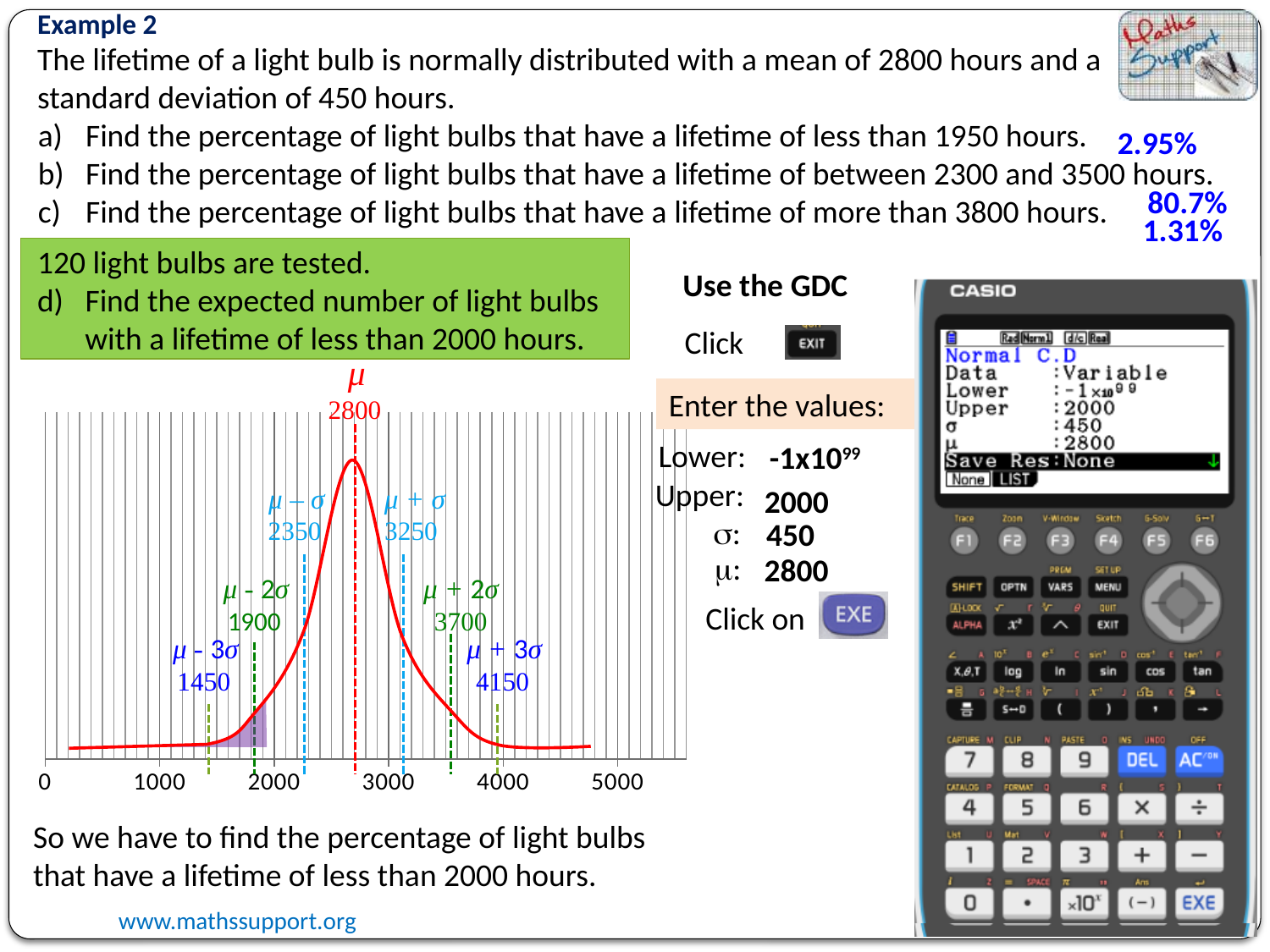
What is the largest value shown on the x axis of the curve? 5000 What value is labelled at μ + 3σ on the curve? 4150 Does the curve rise or fall as x increases from 2800 to 4150? fall What value is labelled at μ + 2σ on the curve? 3700 How many labelled tick values are shown on the x axis of the curve? 6 What value is labelled at μ − 2σ on the curve? 1900 What is the difference between the values labelled at μ + σ and μ − σ on the curve? 900 What value is labelled at μ − σ on the curve? 2350 What is the difference between the values labelled at μ + 3σ and μ − 3σ on the curve? 2700 What value is labelled at μ − 3σ on the curve? 1450 What value is labelled at the mean μ on the normal distribution curve? 2800 What value is labelled at μ + σ on the curve? 3250